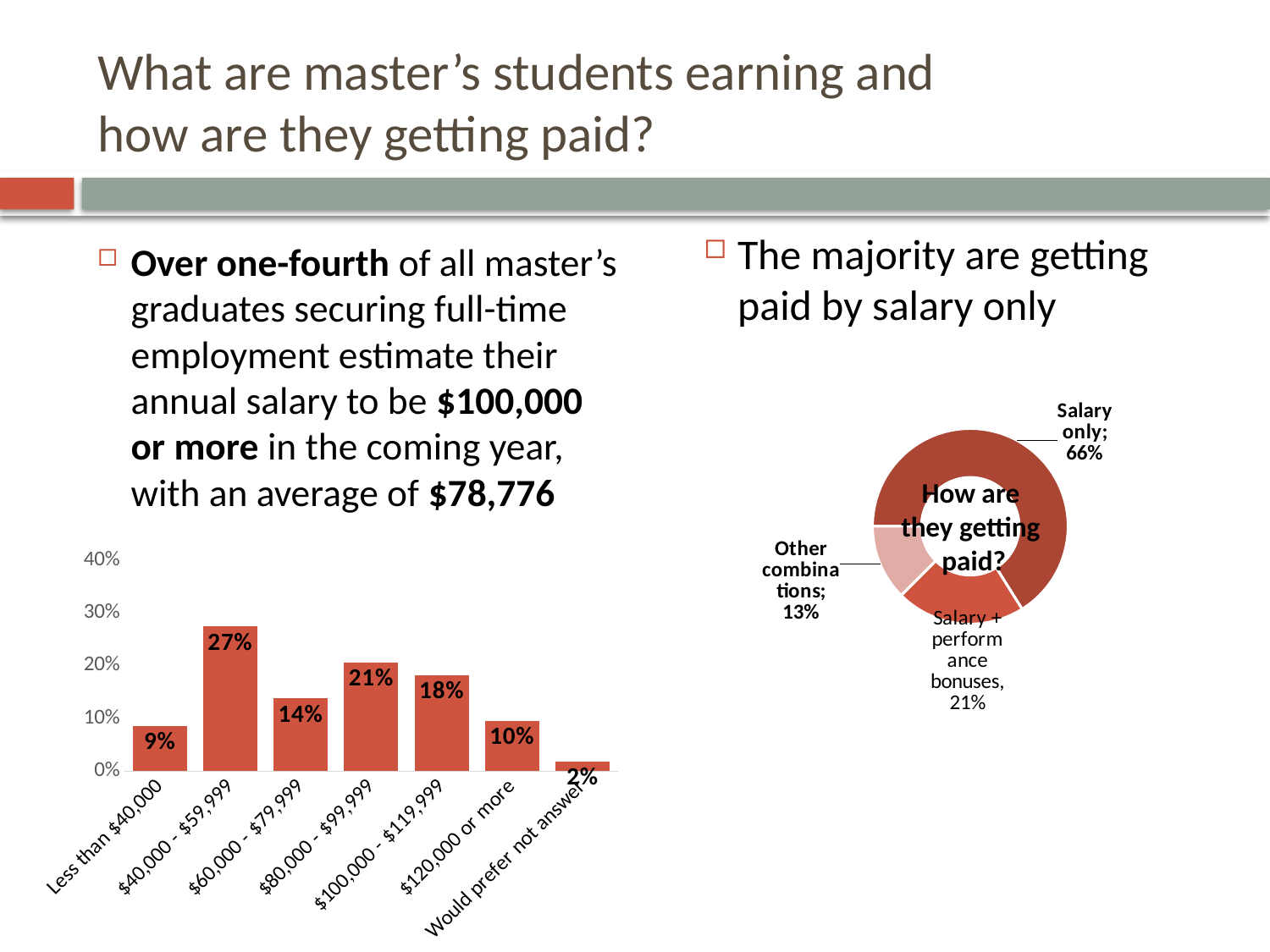
In the bar chart on the left, which category has the lowest percentage? Would prefer not answer In the bar chart on the left, what is the difference between the $80,000 - $99,999 value and the $60,000 - $79,999 value? 7% How many salary categories are shown in the bar chart on the left? 7 What type of chart is the chart on the left of the slide? Bar chart In the bar chart on the left, which is larger: the value for Less than $40,000 or the value for $120,000 or more? $120,000 or more In the bar chart on the left, which salary category has the highest percentage? $40,000 - $59,999 In the 'How are they getting paid?' chart, which category has the smallest share? Other combinations In the bar chart on the left, what percentage of master's graduates estimate a salary of $40,000 - $59,999? 27% In the 'How are they getting paid?' chart, what share is Salary only? 66% In the 'How are they getting paid?' chart, what percentage is Other combinations? 13% In the bar chart on the left, what is the value for the $100,000 - $119,999 category? 18% What type of chart is the 'How are they getting paid?' chart? Doughnut chart